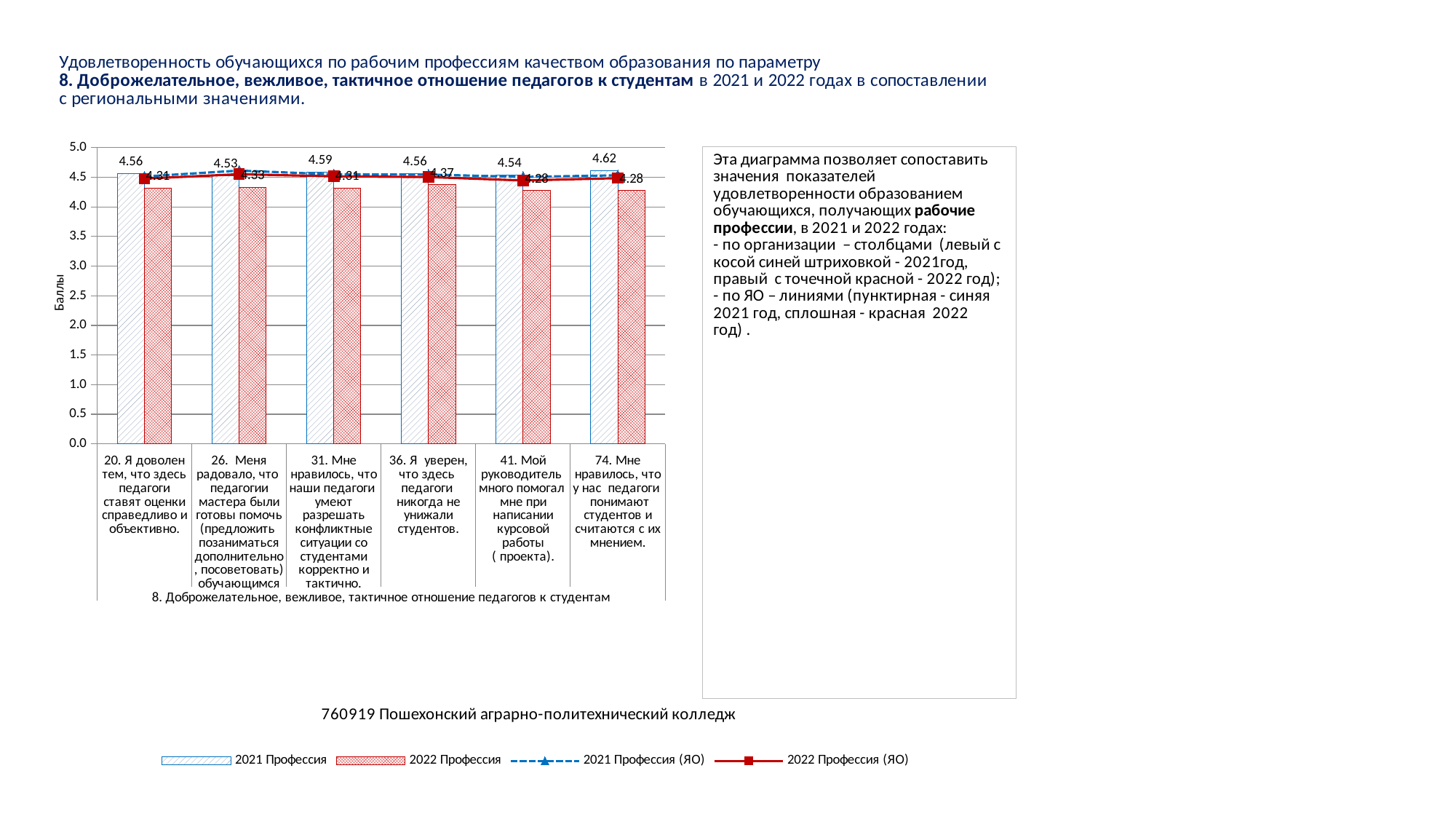
What is the title of the vertical axis? Баллы How many series does the legend list? 4 What kind of chart is shown on the slide? bar chart with line series Which has the larger 2021 Профессия value: category 31 or category 36? 31 What is the value of the 2021 Профессия bar for category 20 (Я доволен тем, что здесь педагоги ставят оценки справедливо и объективно)? 4.56 Which category has the lowest 2021 Профессия value? 26. Меня радовало, что педагогии мастера были готовы помочь What is the value of the 2021 Профессия bar for category 74 (Мне нравилось, что у нас педагоги понимают студентов и считаются с их мнением)? 4.62 Which category has the highest 2021 Профессия value? 74. Мне нравилось, что у нас педагоги понимают студентов и считаются с их мнением. How many categories are shown on the x axis of the chart? 6 Is the 2022 Профессия bar for category 41 greater or less than 4.5? less What is the difference between the highest and lowest 2021 Профессия values (4.62 and 4.53)? 0.09 What is the value of the 2021 Профессия bar for category 41 (Мой руководитель много помогал мне при написании курсовой работы)? 4.54